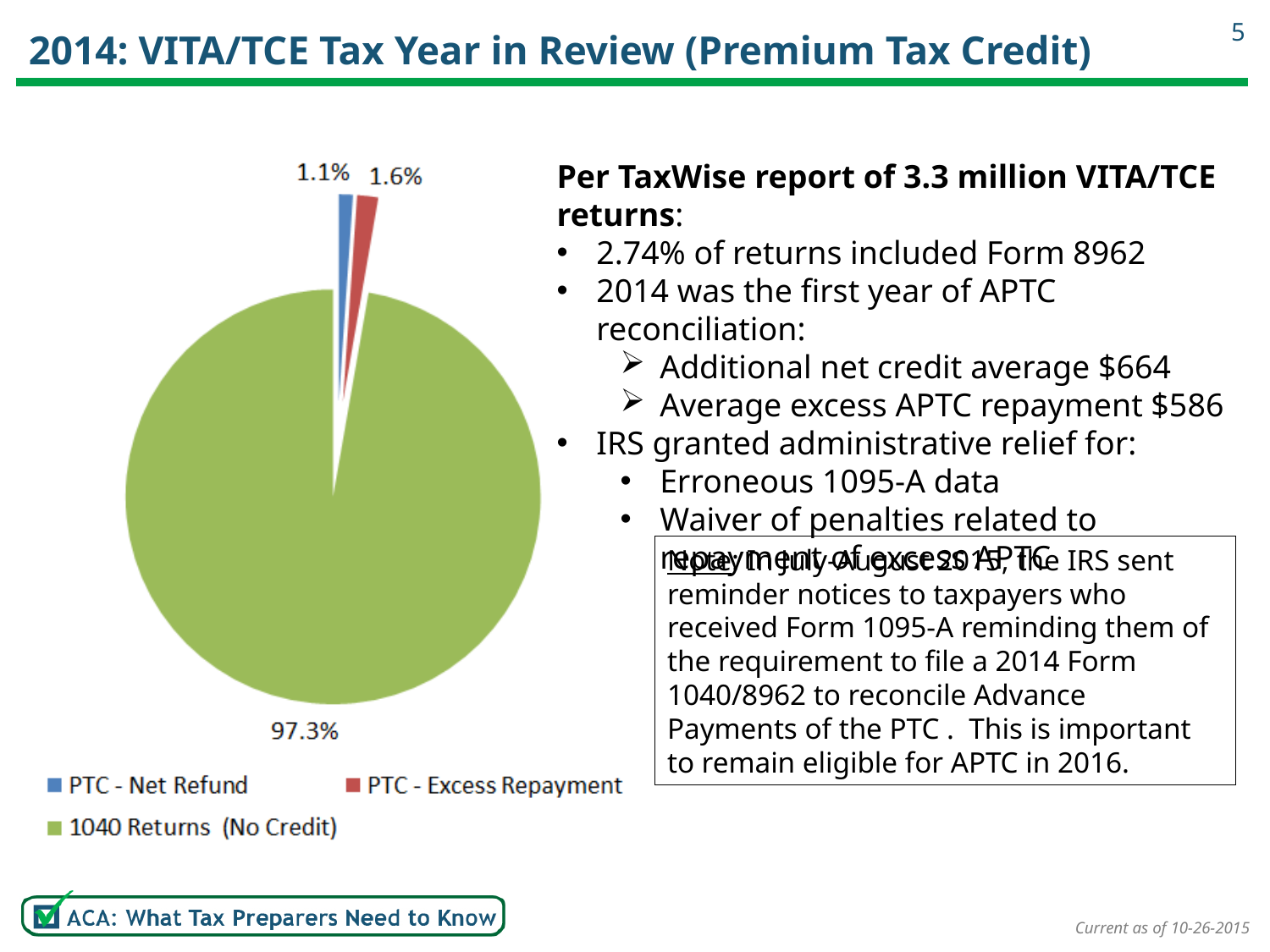
What is the difference between the PTC - Excess Repayment share and the PTC - Net Refund share? 0.5% How many slices does the pie chart have? 3 How many entries does the legend list? 3 What colour is the slice for 1040 Returns (No Credit)? green What colour is the slice for PTC - Net Refund? blue What percentage of the pie is labelled for 1040 Returns (No Credit)? 97.3% What kind of chart is shown on the slide? pie chart What percentage of the pie is labelled for PTC - Excess Repayment? 1.6% Which is larger, the slice for PTC - Net Refund or the slice for PTC - Excess Repayment? PTC - Excess Repayment What percentage of the pie is labelled for PTC - Net Refund? 1.1% Which category has the largest slice of the pie? 1040 Returns (No Credit) Which category has the smallest slice of the pie? PTC - Net Refund